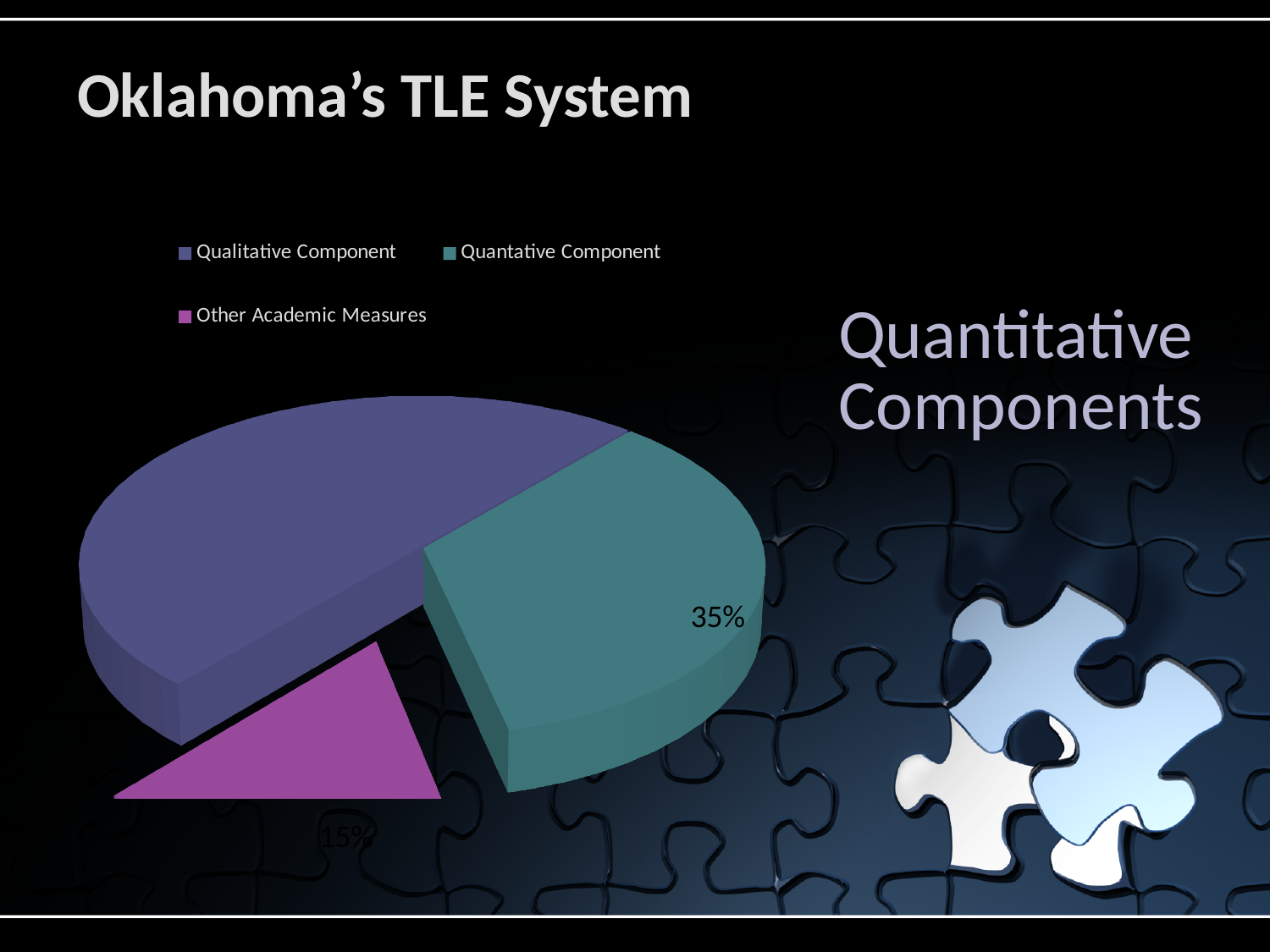
How many entries does the legend of the pie chart list? 3 Which is larger, the Qualitative Component slice or the Quantative Component slice? Qualitative Component Which slice of the pie chart is the largest? Qualitative Component Which is larger, the Quantative Component slice or the Other Academic Measures slice? Quantative Component What percentage is shown for the Quantative Component slice? 35% How many slices does the pie chart have? 3 What kind of chart is shown on the slide? Pie chart What percentage is shown for the Other Academic Measures slice? 15% What colour is the Quantative Component slice in the pie chart? Teal What is the difference in percentage points between the Quantative Component slice and the Other Academic Measures slice? 20 Which slice of the pie chart is the smallest? Other Academic Measures What are the three entries listed in the pie chart's legend? Qualitative Component, Quantative Component, Other Academic Measures